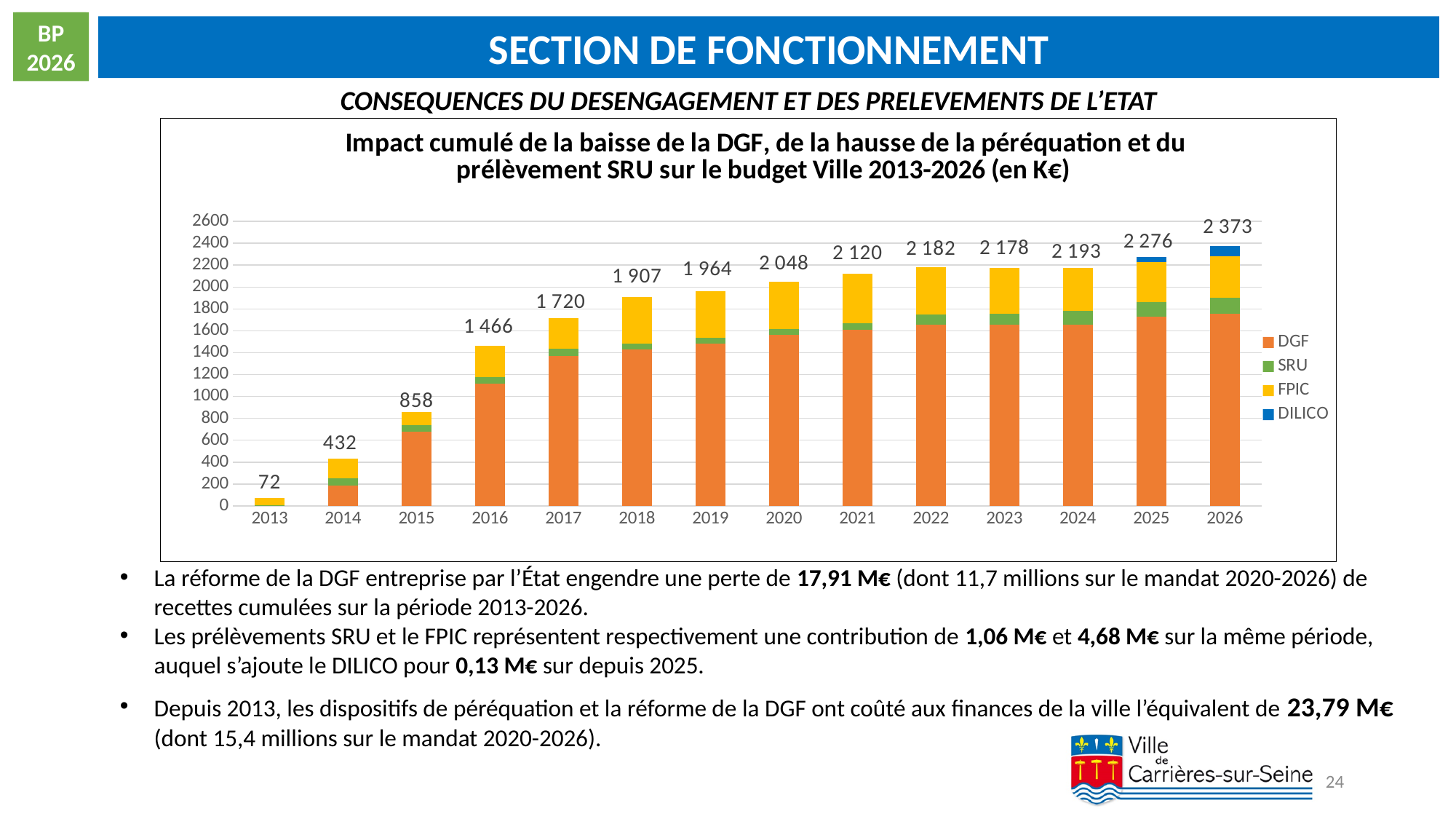
Is the DGF value for 2016 greater or less than 1000? greater How many series does the legend list? 4 What kind of chart is shown? stacked bar chart Which year has the larger total, 2022 or 2023? 2022 What is the total value labelled for 2026? 2 373 Do the totals generally rise or fall from 2013 to 2026? rise Which year has the highest total? 2026 What is the total value labelled for 2016? 1 466 Which year has the lowest total? 2013 How many years are shown on the x axis? 14 Which series is shown in orange in the legend? DGF What is the difference between the totals for 2026 and 2025? 97